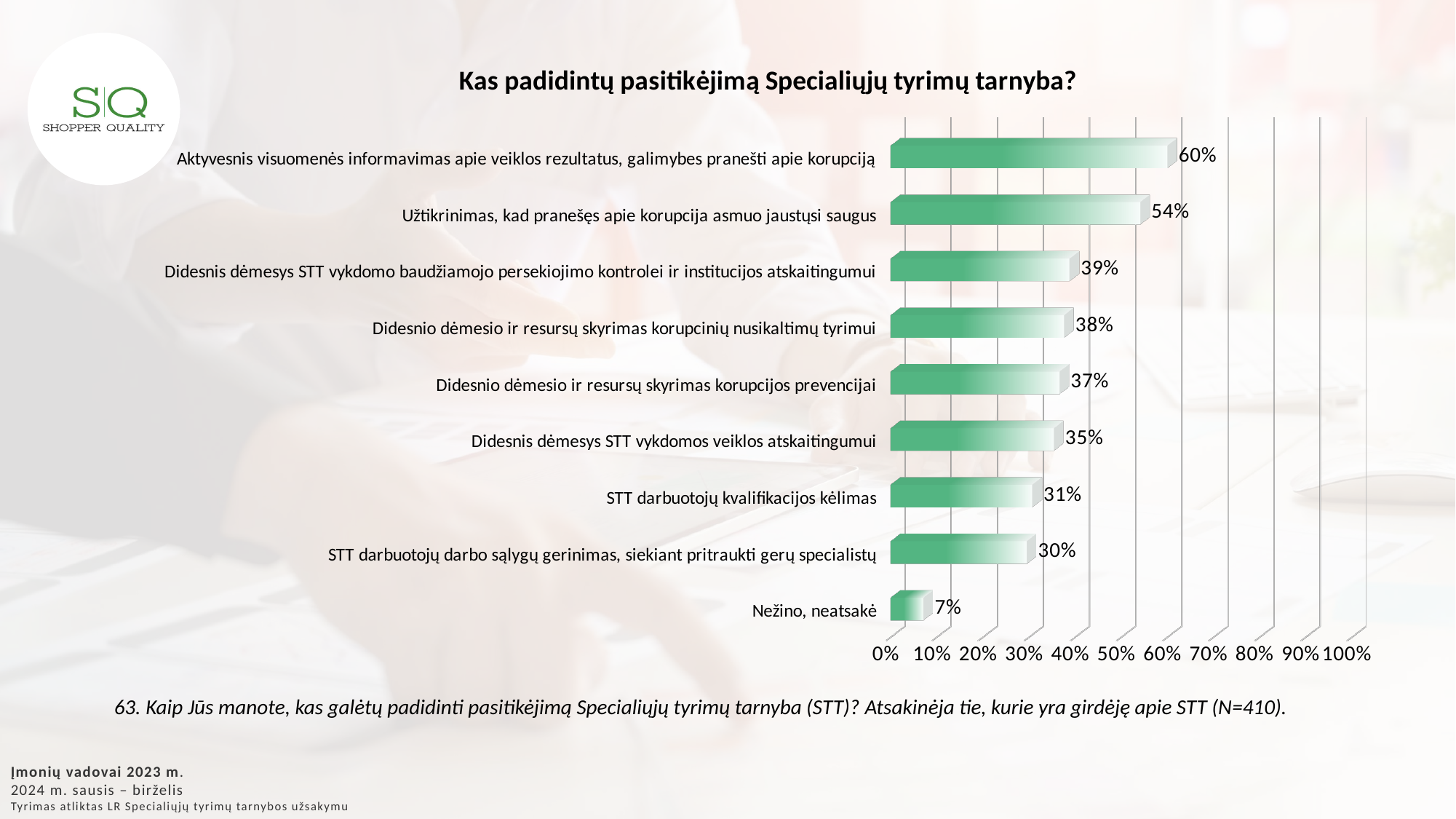
What is the value for "Aktyvesnis visuomenės informavimas apie veiklos rezultatus, galimybes pranešti apie korupciją"? 60% Which category has the highest value? Aktyvesnis visuomenės informavimas apie veiklos rezultatus, galimybes pranešti apie korupciją What is the value for "Nežino, neatsakė"? 7% What kind of chart is shown on the slide? Bar chart Is the value for "Užtikrinimas, kad pranešęs apie korupcija asmuo jaustųsi saugus" greater or less than 50%? greater What is the title of the chart? Kas padidintų pasitikėjimą Specialiųjų tyrimų tarnyba? Which category has the lowest value? Nežino, neatsakė Which is larger: the value for "Didesnis dėmesys STT vykdomos veiklos atskaitingumui" or the value for "STT darbuotojų darbo sąlygų gerinimas, siekiant pritraukti gerų specialistų"? Didesnis dėmesys STT vykdomos veiklos atskaitingumui What is the value for "STT darbuotojų kvalifikacijos kėlimas"? 31% What is the value for "Didesnio dėmesio ir resursų skyrimas korupcijos prevencijai"? 37% How many categories are shown in the chart? 9 What is the difference between the values for "Aktyvesnis visuomenės informavimas apie veiklos rezultatus, galimybes pranešti apie korupciją" and "Užtikrinimas, kad pranešęs apie korupcija asmuo jaustųsi saugus"? 6%